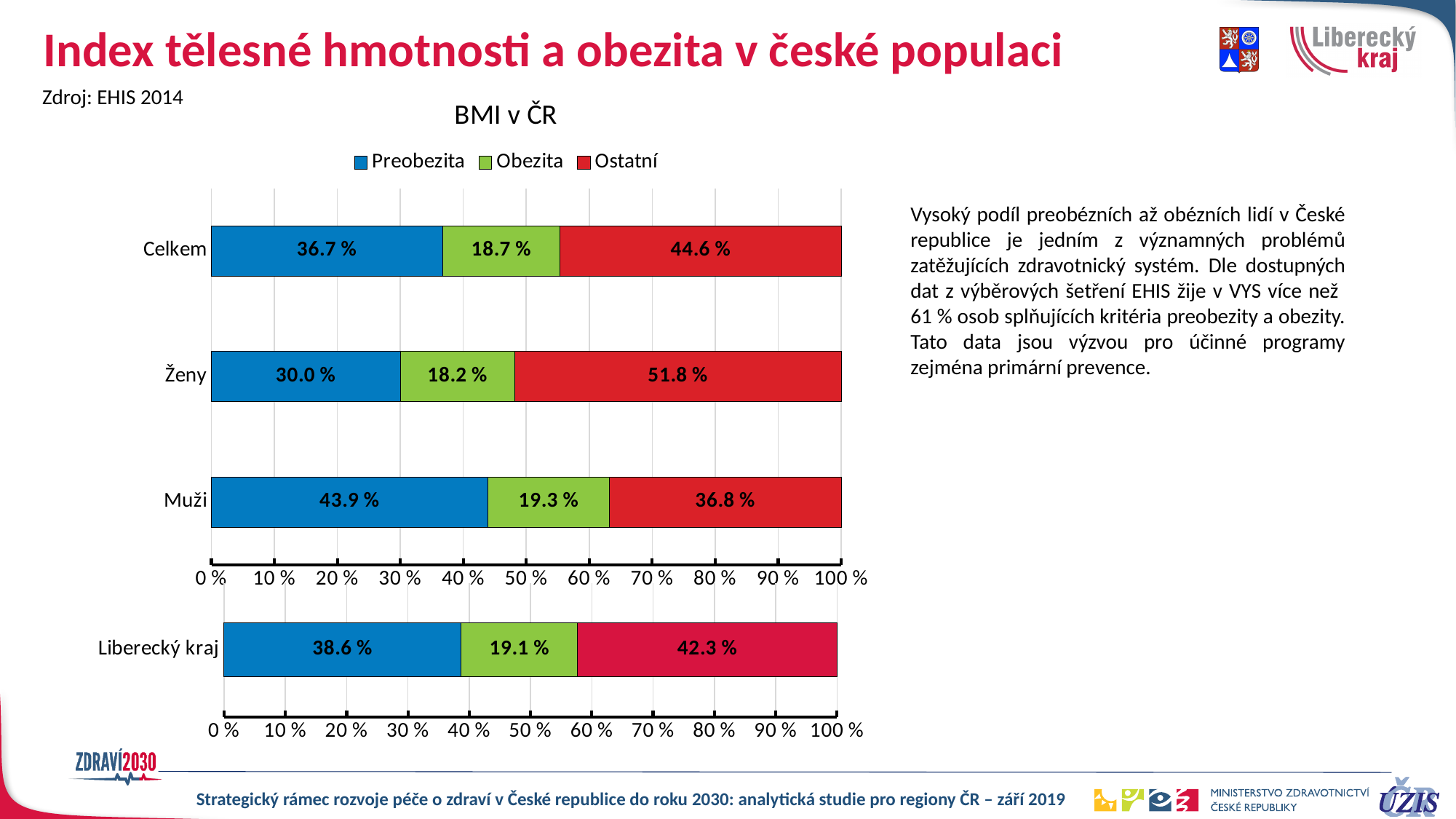
In the top chart (BMI v ČR), what is the Preobezita value for Celkem? 36.7 % In the top chart (BMI v ČR), which category has the highest Preobezita value? Muži In the top chart (BMI v ČR), what is the difference between the Preobezita values for Muži and Ženy? 13.9 % In the top chart (BMI v ČR), what is the Ostatní value for Ženy? 51.8 % In the bottom chart, what is the Obezita value for Liberecký kraj? 19.1 % How many series does the legend of the top chart (BMI v ČR) list? 3 In the top chart (BMI v ČR), what is the combined Preobezita and Obezita share for Muži? 63.2 % In the top chart (BMI v ČR), which category has the lowest Ostatní value? Muži Which colour represents the Obezita series in the top chart (BMI v ČR)? green What kind of chart is the top chart (BMI v ČR)? stacked bar chart How many categories are shown in the top chart (BMI v ČR)? 3 Is the Preobezita value for Liberecký kraj in the bottom chart larger or smaller than the Preobezita value for Celkem in the top chart? larger